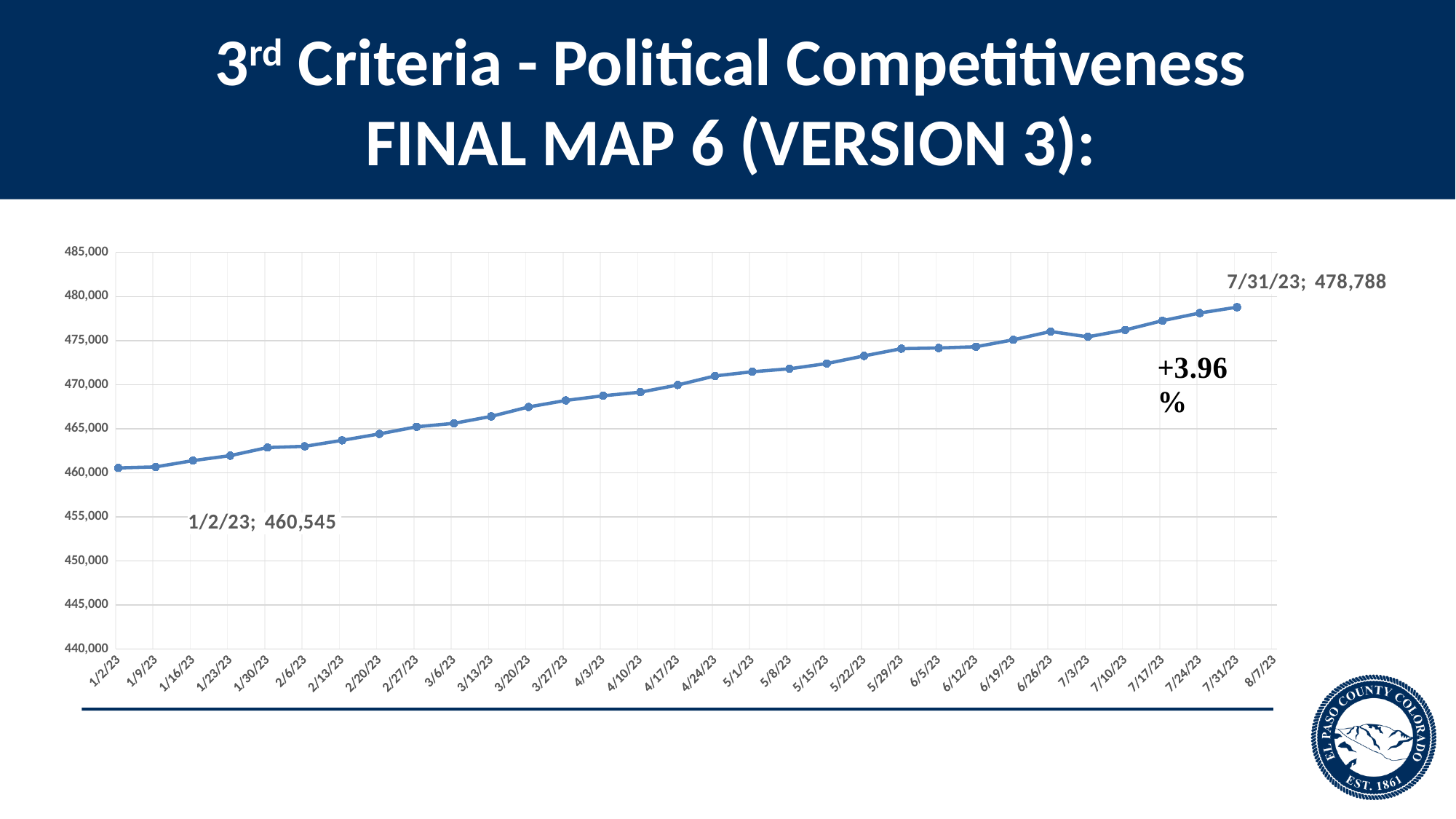
What value is labelled for 7/31/23 on the chart? 478,788 Is the value for 5/1/23 greater or less than 470,000? greater Is the value for 4/3/23 greater or less than 465,000? greater What kind of chart is shown on the slide? line chart What is the difference between the labelled values for 7/31/23 and 1/2/23? 18,243 Is the value for 2/6/23 greater or less than 465,000? less What value is labelled for 1/2/23 on the chart? 460,545 Which date has the highest value on the chart? 7/31/23 What percentage change is annotated on the chart? +3.96% Do the values generally rise or fall from 1/2/23 to 7/31/23? rise Which is larger, the value for 7/31/23 or the value for 1/2/23? 7/31/23